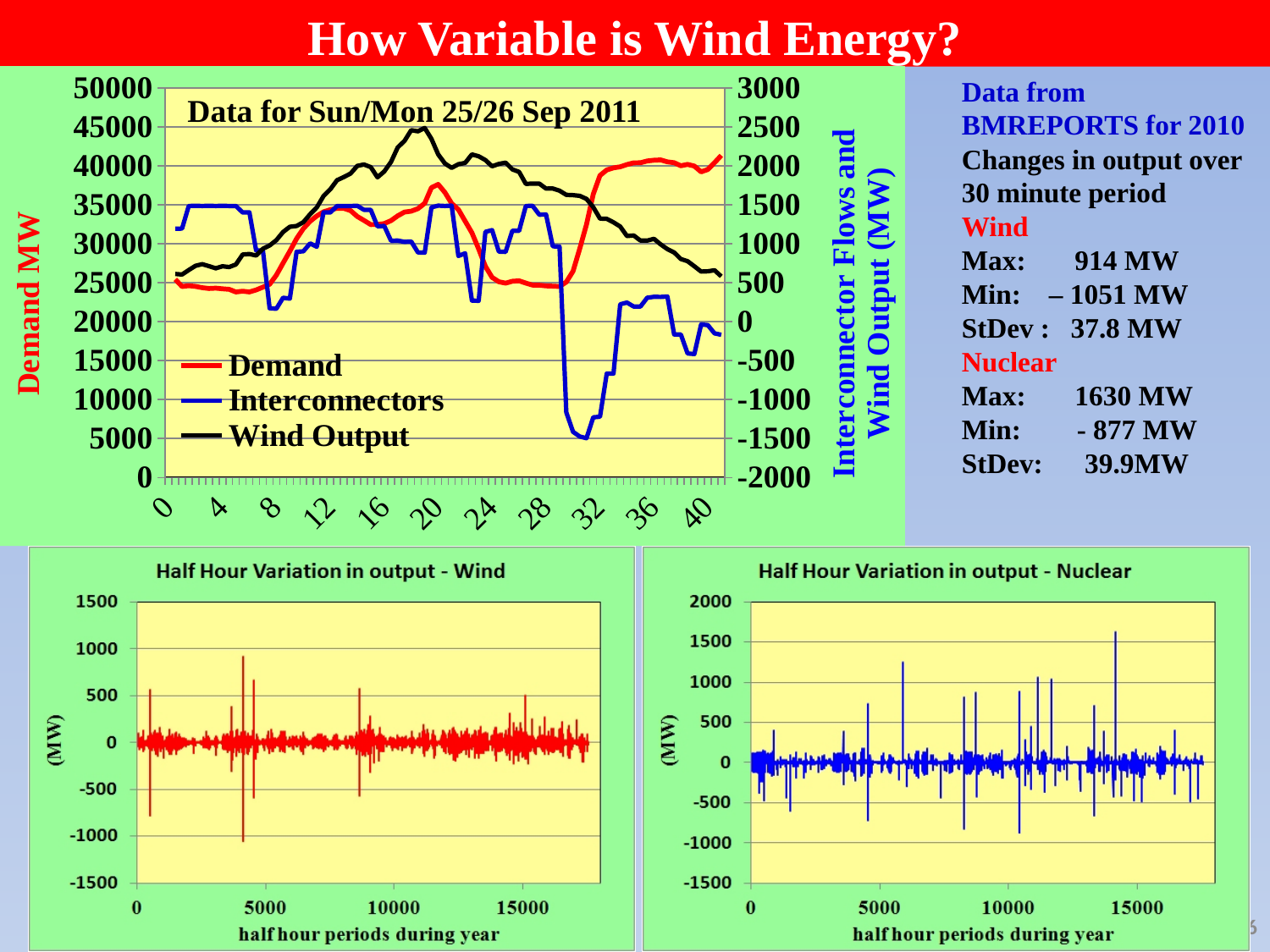
In the top chart 'Data for Sun/Mon 25/26 Sep 2011', is the peak Wind Output value greater or less than 2000? greater In the top chart 'Data for Sun/Mon 25/26 Sep 2011', is the Demand value at period 0 greater or less than 30000? less In the top chart 'Data for Sun/Mon 25/26 Sep 2011', does the Wind Output series rise or fall between period 20 and period 40? fall In the top chart 'Data for Sun/Mon 25/26 Sep 2011', is the lowest Interconnectors value greater or less than -1000? less How many series does the legend of the top chart 'Data for Sun/Mon 25/26 Sep 2011' list? 3 In the top chart 'Data for Sun/Mon 25/26 Sep 2011', does the Demand series rise or fall between period 28 and period 36? rise In the top chart 'Data for Sun/Mon 25/26 Sep 2011', what is the label of the left vertical axis? Demand MW In the top chart 'Data for Sun/Mon 25/26 Sep 2011', which series is drawn in black? Wind Output What kind of chart is the top chart titled 'Data for Sun/Mon 25/26 Sep 2011'? line chart